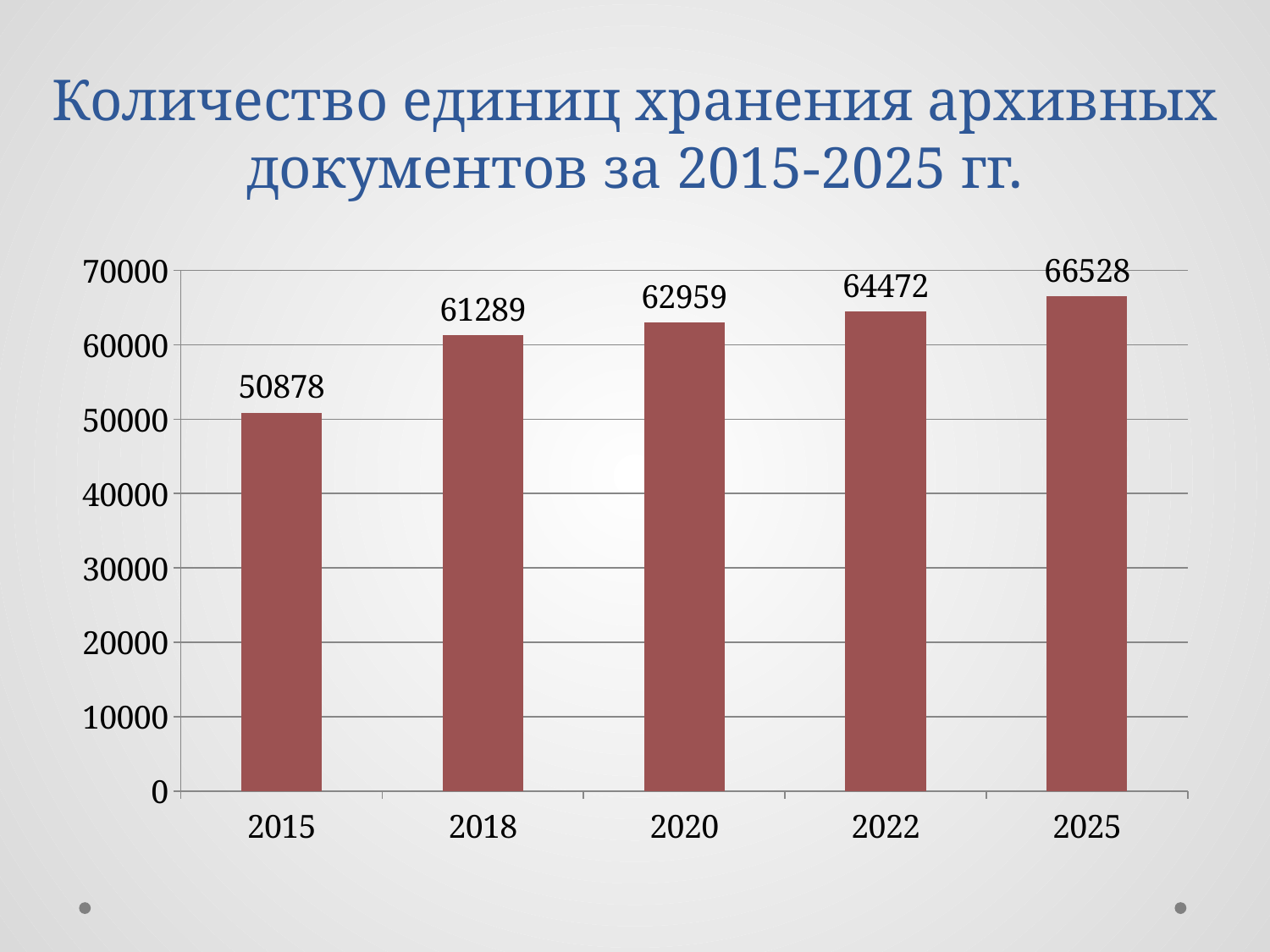
Which year has the lowest value? 2015 What is the difference between the values for 2025 and 2015? 15650 What kind of chart is shown on the slide? bar chart Is the value for 2018 greater or less than 60000? greater Which is larger, the value for 2018 or the value for 2022? 2022 What is the value for 2015? 50878 Which year has the highest value? 2025 Do the values rise or fall from 2015 to 2025? rise What is the difference between the values for 2022 and 2018? 3183 How many years are shown on the x axis? 5 What is the value for 2020? 62959 What is the value for 2025? 66528